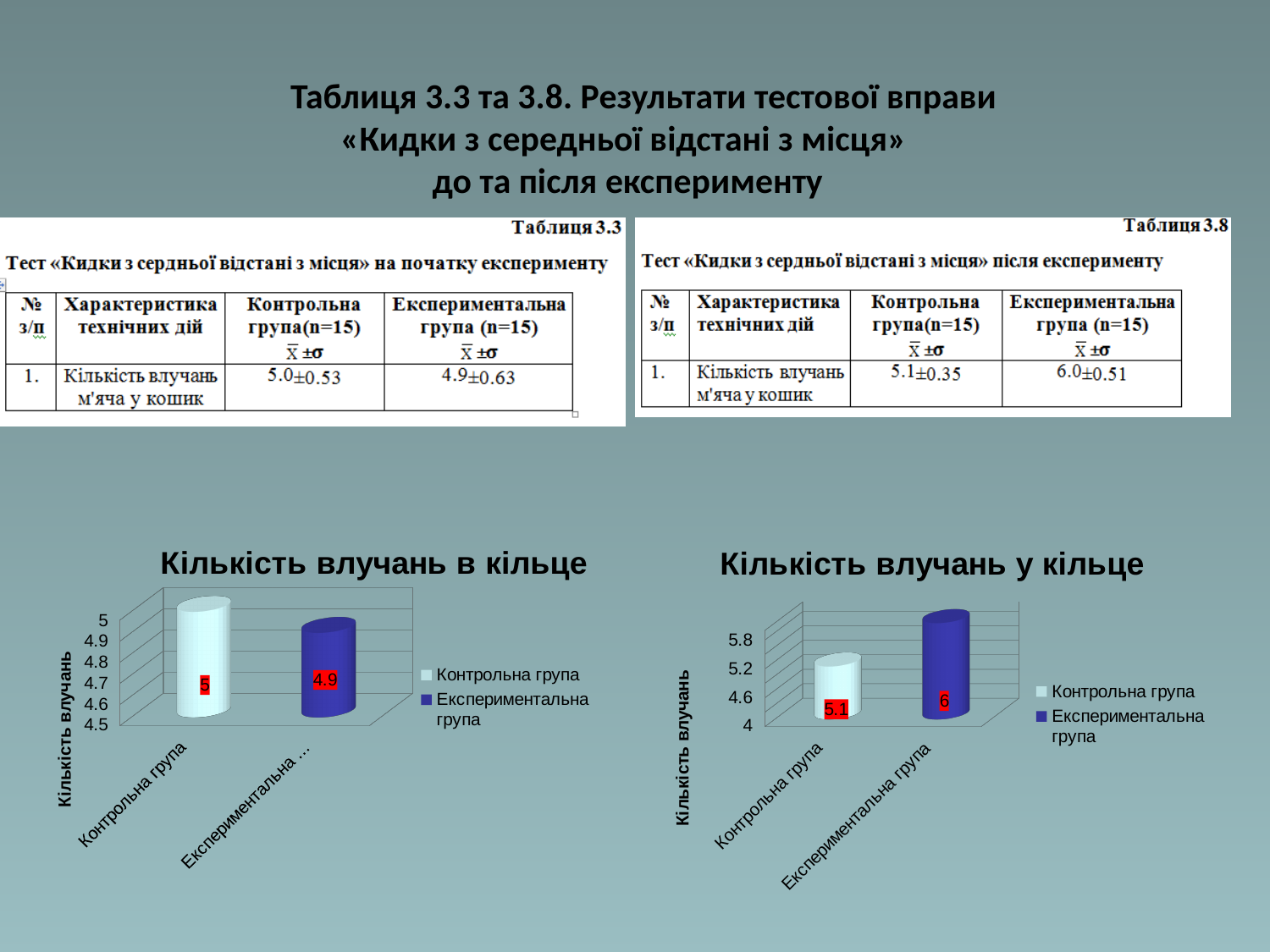
In the left chart (Кількість влучань в кільце), what is the value for Експериментальна група? 4.9 How many entries does the legend of the right chart (Кількість влучань у кільце) list? 2 What kind of chart is the left chart (Кількість влучань в кільце)? Bar chart In the left chart (Кількість влучань в кільце), which group has the lowest value? Експериментальна група In the left chart (Кількість влучань в кільце), what is the value for Контрольна група? 5 In the right chart (Кількість влучань у кільце), what is the value for Контрольна група? 5.1 In the right chart (Кількість влучань у кільце), is the value for Експериментальна група greater or less than 5.8? greater In the right chart (Кількість влучань у кільце), which group has the highest value? Експериментальна група How many bars are plotted in the left chart (Кількість влучань в кільце)? 2 In the right chart (Кількість влучань у кільце), what is the difference between the values for Експериментальна група and Контрольна група? 0.9 In the left chart (Кількість влучань в кільце), what is the difference between the values for Контрольна група and Експериментальна група? 0.1 In the right chart (Кількість влучань у кільце), what is the value for Експериментальна група? 6